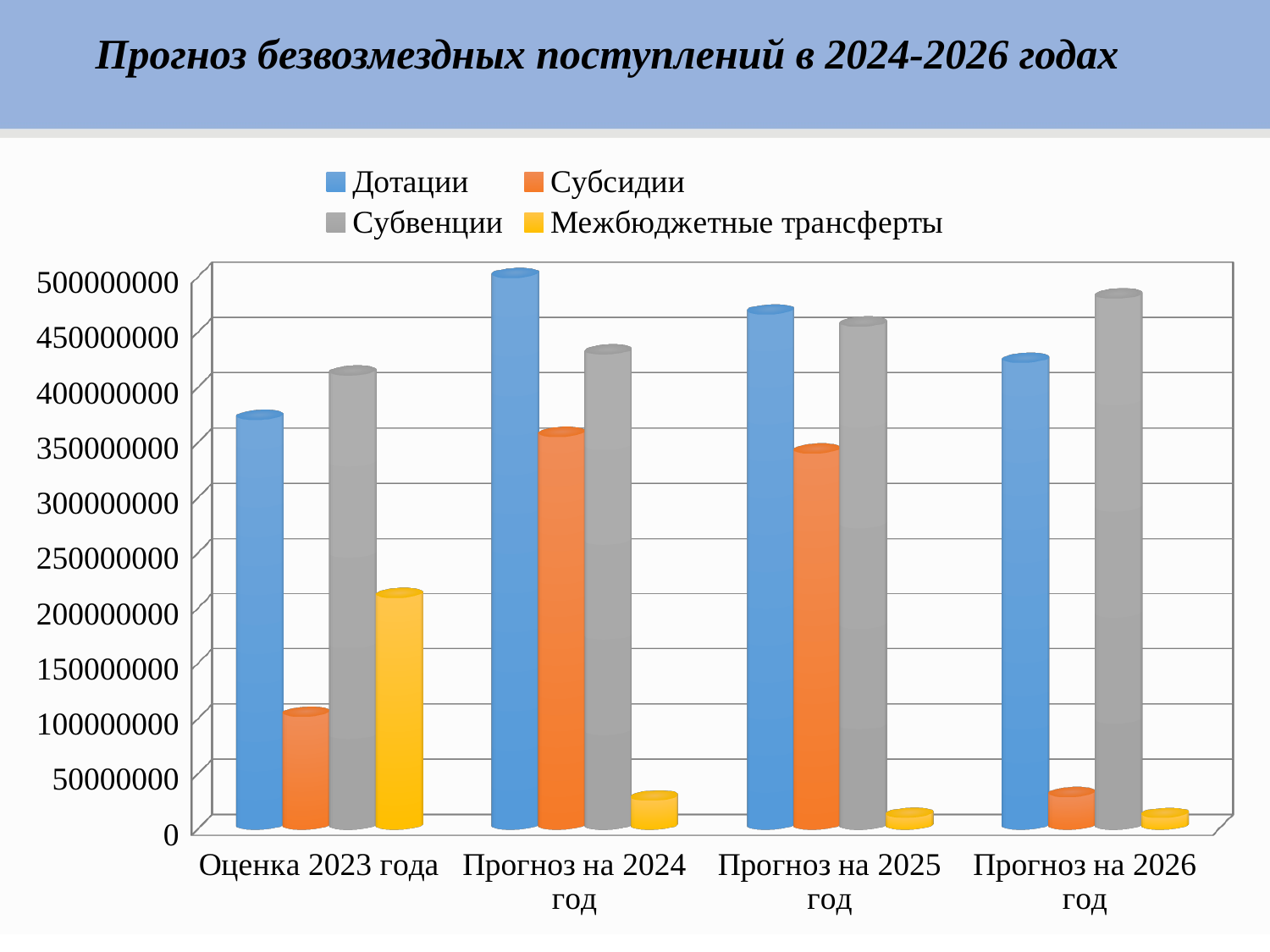
Do the values for Субвенции rise or fall from Оценка 2023 года to Прогноз на 2026 год? rise What is the title of the slide's chart? Прогноз безвозмездных поступлений в 2024-2026 годах In Прогноз на 2024 год, which is larger: Дотации or Субвенции? Дотации In Прогноз на 2026 год, which is larger: Дотации or Субвенции? Субвенции In which category is the value for Дотации the highest? Прогноз на 2024 год Is the value for Субвенции in Прогноз на 2026 год greater or less than 450000000? greater How many series does the legend list? 4 What kind of chart is shown on the slide? Bar chart Is the value for Межбюджетные трансферты in Оценка 2023 года greater or less than 150000000? greater How many categories are shown on the x axis? 4 Is the value for Дотации in Оценка 2023 года greater or less than 400000000? less Which series is shown in yellow in the legend? Межбюджетные трансферты